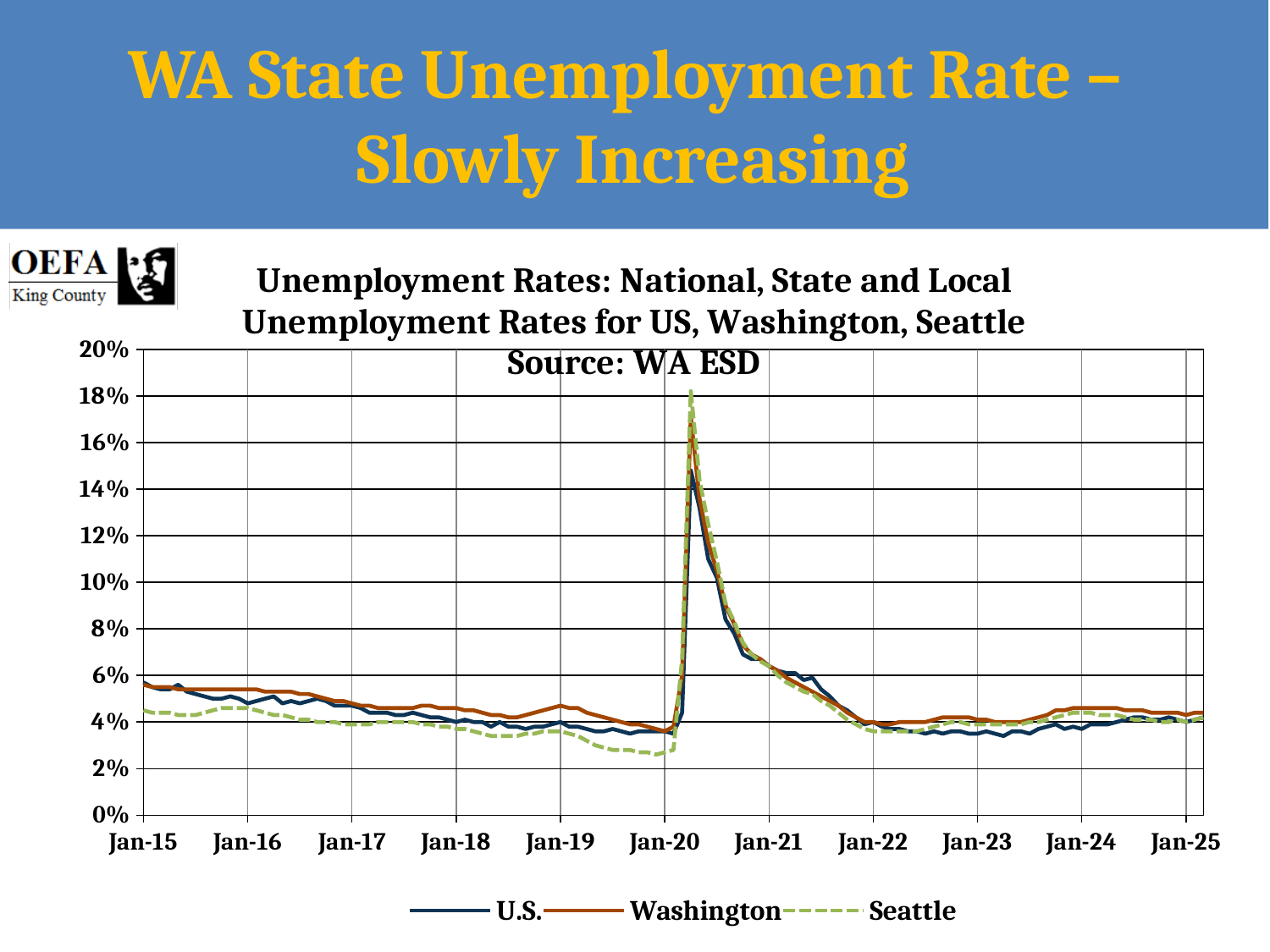
Is the value for Seattle at Jan-20 greater or less than 4%? less What source is cited in the chart title? WA ESD Which series has the lowest value at Jan-20? Seattle How many series does the legend list? 3 Which series reaches the highest peak in 2020? Seattle Is the peak value for Seattle in 2020 greater or less than 16%? greater Does the U.S. unemployment rate rise or fall from Jan-15 to Jan-19? fall Is the value for Washington at Jan-15 greater or less than 4%? greater What kind of chart is shown on the slide? Line chart Which series are listed in the chart legend? U.S., Washington, Seattle How many year labels are shown on the x axis? 11